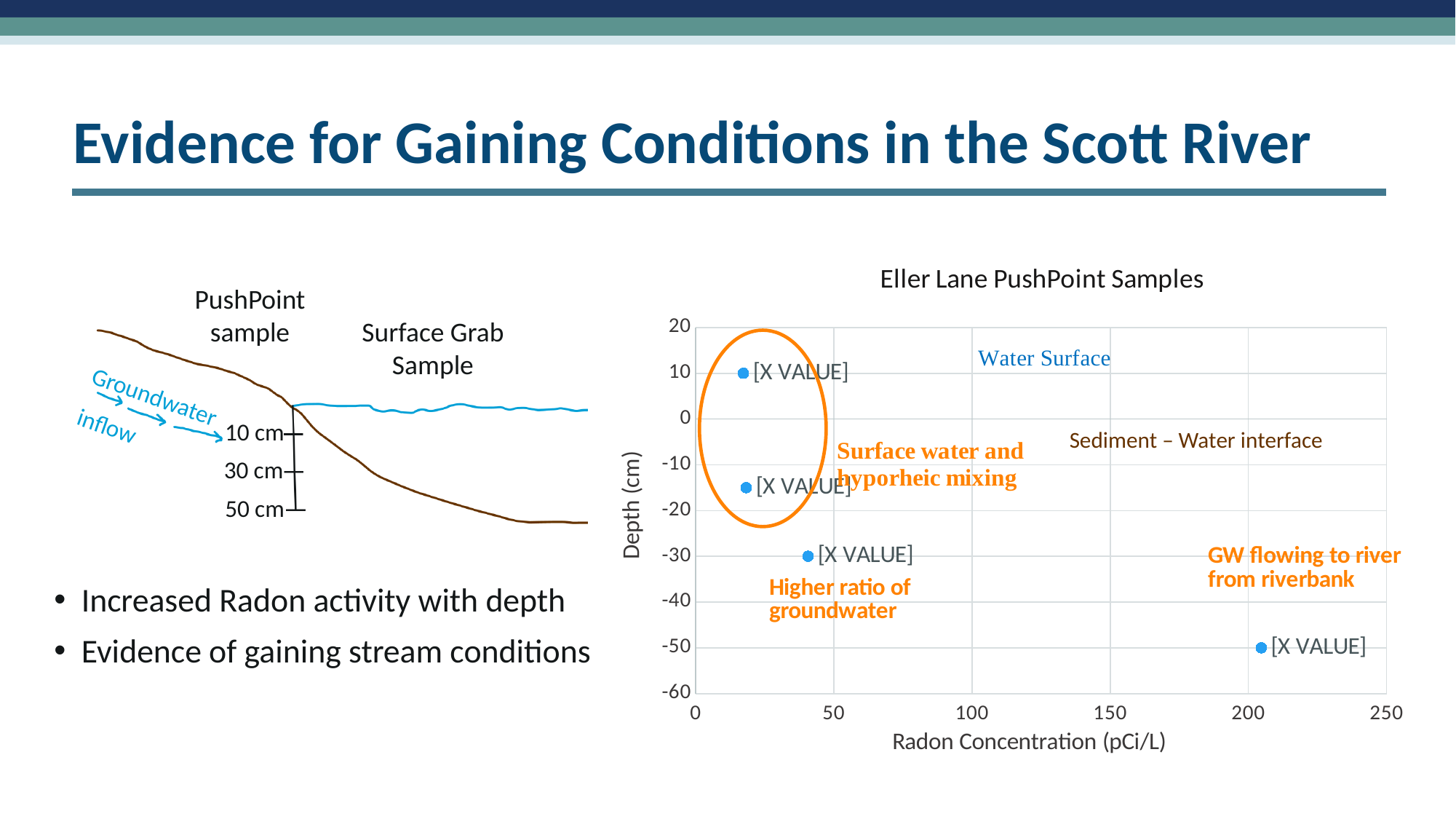
What is the title of the chart? Eller Lane PushPoint Samples What is the depth (cm) of the point with the highest radon concentration? -50 Is the radon concentration of the point at depth -30 cm greater or less than 50? less How many data points are plotted in the chart? 4 What kind of chart is shown on the slide? scatter chart As radon concentration increases along the x axis, does the depth value rise or fall? fall What is the label of the x axis of the chart? Radon Concentration (pCi/L) Which point has a higher radon concentration: the one at depth -30 cm or the one at depth -50 cm? the one at depth -50 cm At which depth is the point with the highest radon concentration located? -50 Is the radon concentration of the point at depth 10 cm greater or less than 50? less Is the depth of the point with the highest radon concentration greater or less than -40? less